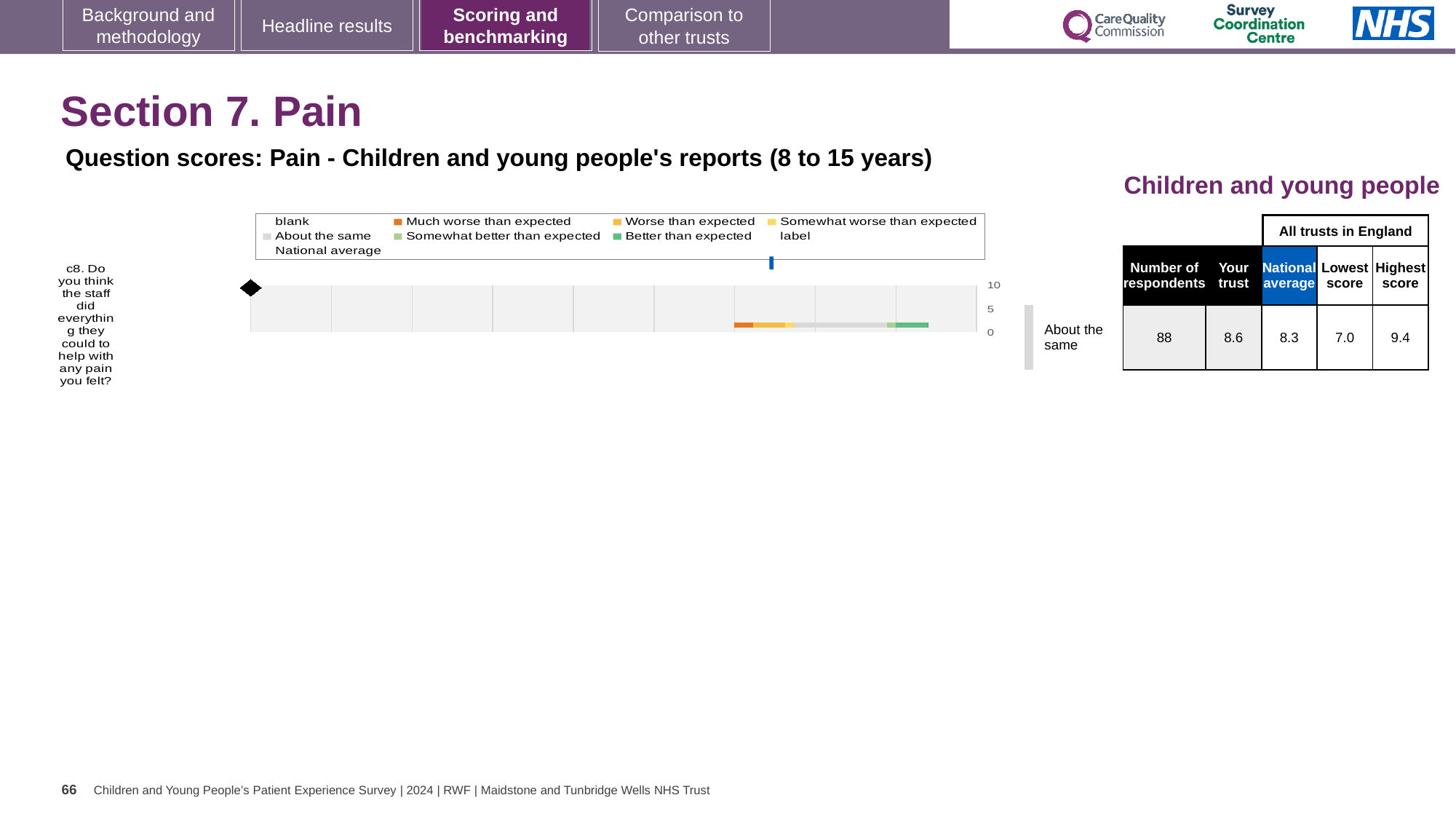
What kind of chart is used to show the question scores? Bar chart What is the difference between the highest and lowest trust scores for question c8? 2.4 What benchmark category is the trust's result for question c8 assigned to? About the same Which is higher for question c8: the trust's score or the national average? Your trust (8.6) What is the 'Your trust' score for question c8 (Do you think the staff did everything they could to help with any pain you felt?)? 8.6 What is the national average score for question c8? 8.3 How many survey questions are plotted on the chart? 1 Is the trust's score for question c8 greater or less than 5 on the chart axis? greater By how much does the trust's score for c8 exceed the national average? 0.3 What is the lowest score among all trusts in England for question c8? 7.0 How many respondents answered question c8? 88 What is the highest score among all trusts in England for question c8? 9.4